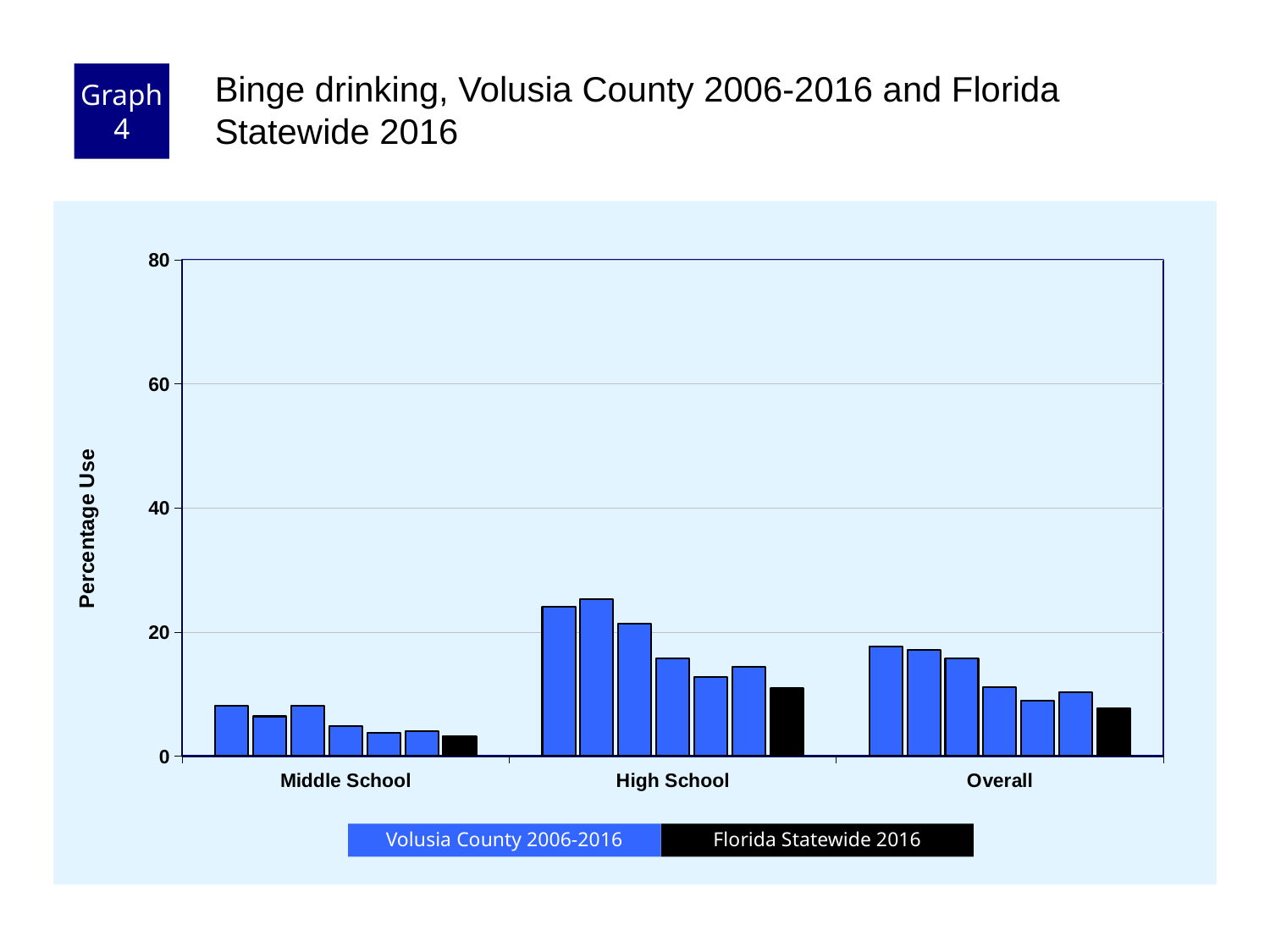
How many categories are shown on the x axis? 3 How many series does the legend list? 2 Do the Volusia County bars for Overall generally rise or fall from left to right? fall Which category has the lowest binge drinking percentages? Middle School Is the Florida Statewide 2016 value for Middle School greater or less than 20? less What is the label on the y axis? Percentage Use Is the Florida Statewide 2016 value for High School greater or less than 20? less Is the first Volusia County bar for High School greater or less than 20? greater Which category has the highest binge drinking percentages? High School Which is larger, the Florida Statewide 2016 value for High School or for Middle School? High School What kind of chart is shown on the slide? Bar chart